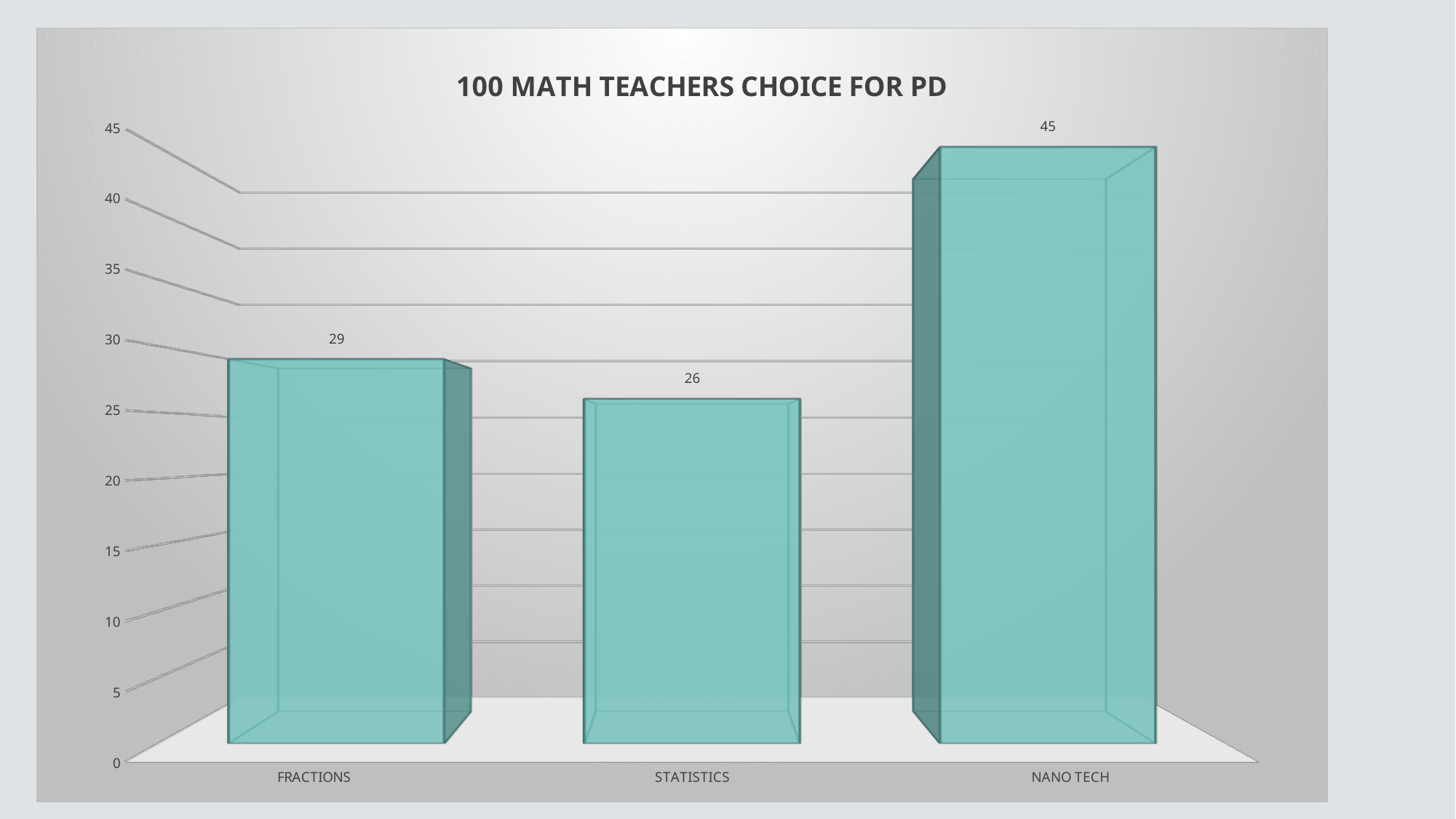
What is the difference between the values for NANO TECH and FRACTIONS? 16 What kind of chart is shown on the slide? Bar chart How many categories are shown on the chart? 3 What is the value for STATISTICS? 26 What is the difference between the values for FRACTIONS and STATISTICS? 3 Which category has the highest value? NANO TECH What is the title of the chart? 100 MATH TEACHERS CHOICE FOR PD What is the value for FRACTIONS? 29 Which is larger, the value for FRACTIONS or the value for STATISTICS? FRACTIONS What is the value for NANO TECH? 45 Is the value for NANO TECH greater or less than 40? greater Which category has the lowest value? STATISTICS